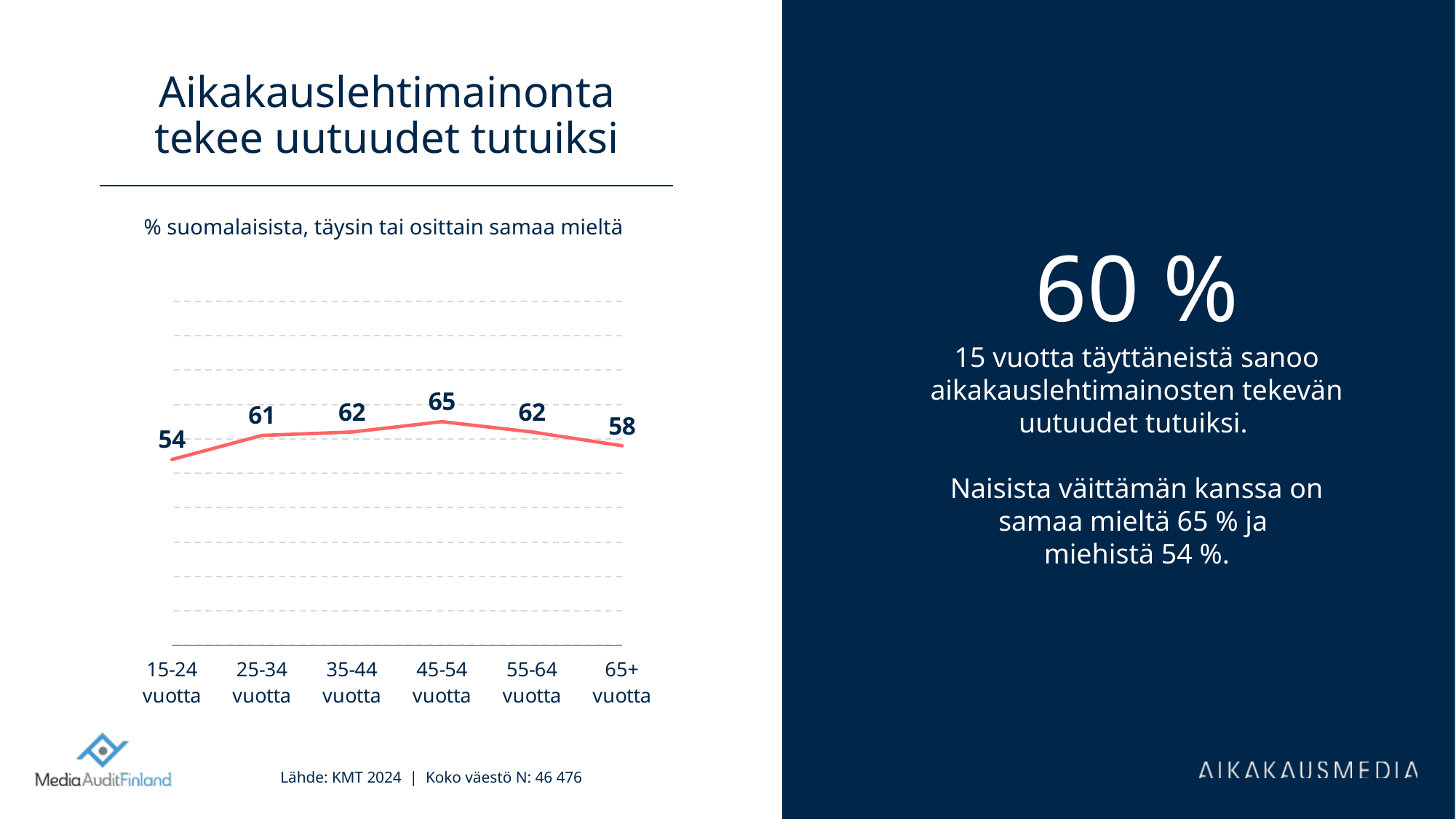
What is the value for the 65+ vuotta age group? 58 Which age group has the lowest value? 15-24 vuotta Which age group has the highest value? 45-54 vuotta What kind of chart is shown on the slide? line chart What is the subtitle shown above the chart? % suomalaisista, täysin tai osittain samaa mieltä What is the value for the 15-24 vuotta age group? 54 Which is larger, the value for 55-64 vuotta or the value for 65+ vuotta? 55-64 vuotta What is the value for the 45-54 vuotta age group? 65 How many age groups are plotted on the chart? 6 Do the values rise or fall from 15-24 vuotta to 45-54 vuotta? rise What is the difference between the values for 25-34 vuotta and 65+ vuotta? 3 What is the difference between the values for 45-54 vuotta and 15-24 vuotta? 11